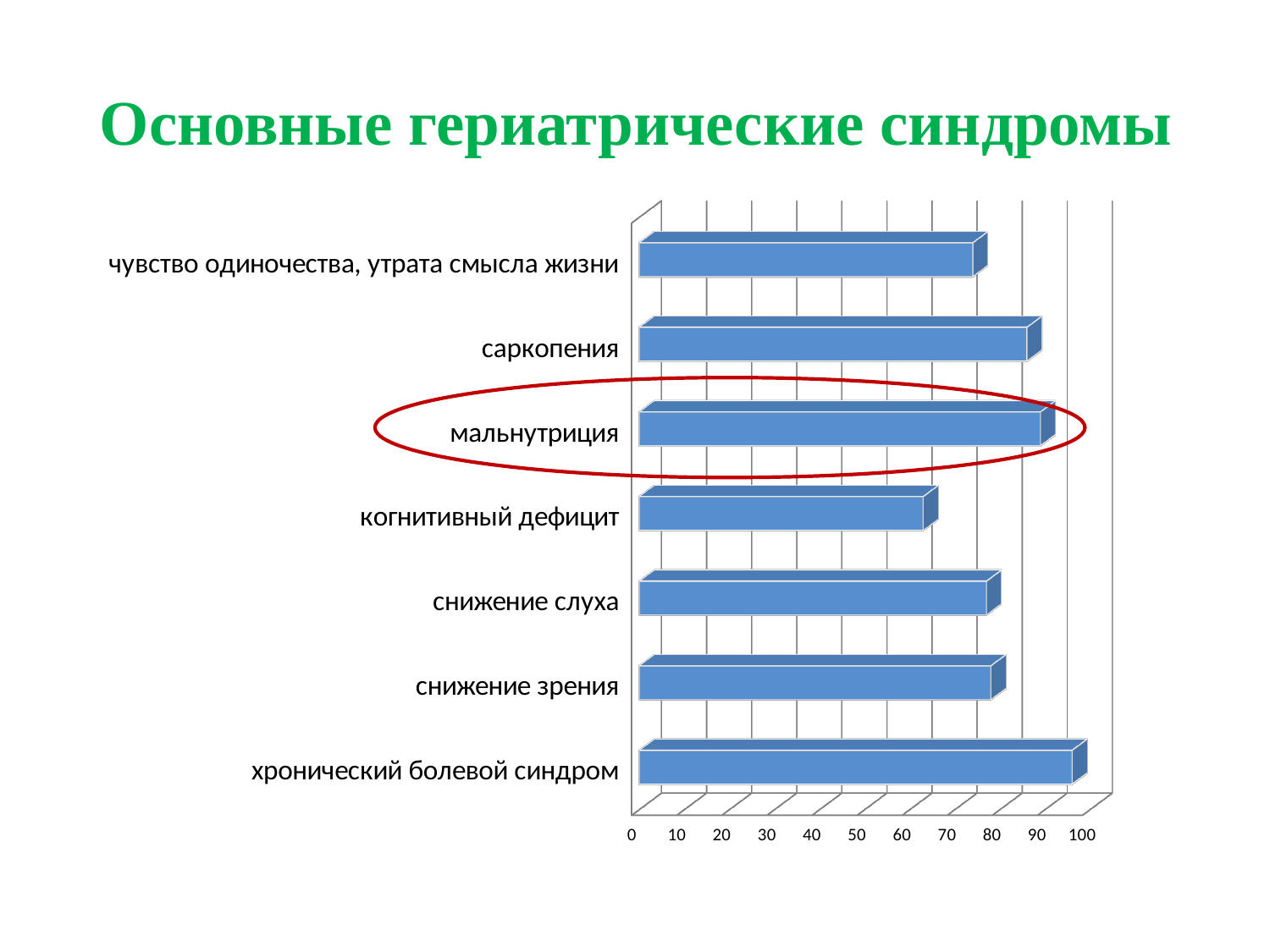
Which is larger, the value for саркопения or the value for когнитивный дефицит? саркопения How many categories are plotted in the chart? 7 What kind of chart is shown on the slide? bar chart Is the value for мальнутриция greater or less than 80? greater Which category has the lowest value in the chart? когнитивный дефицит Which category on the chart is circled in red? мальнутриция Is the value for чувство одиночества, утрата смысла жизни greater or less than 80? less What is the title of the slide containing the chart? Основные гериатрические синдромы Which category has the highest value in the chart? хронический болевой синдром Is the value for хронический болевой синдром greater or less than 90? greater Which is larger, the value for хронический болевой синдром or the value for чувство одиночества, утрата смысла жизни? хронический болевой синдром